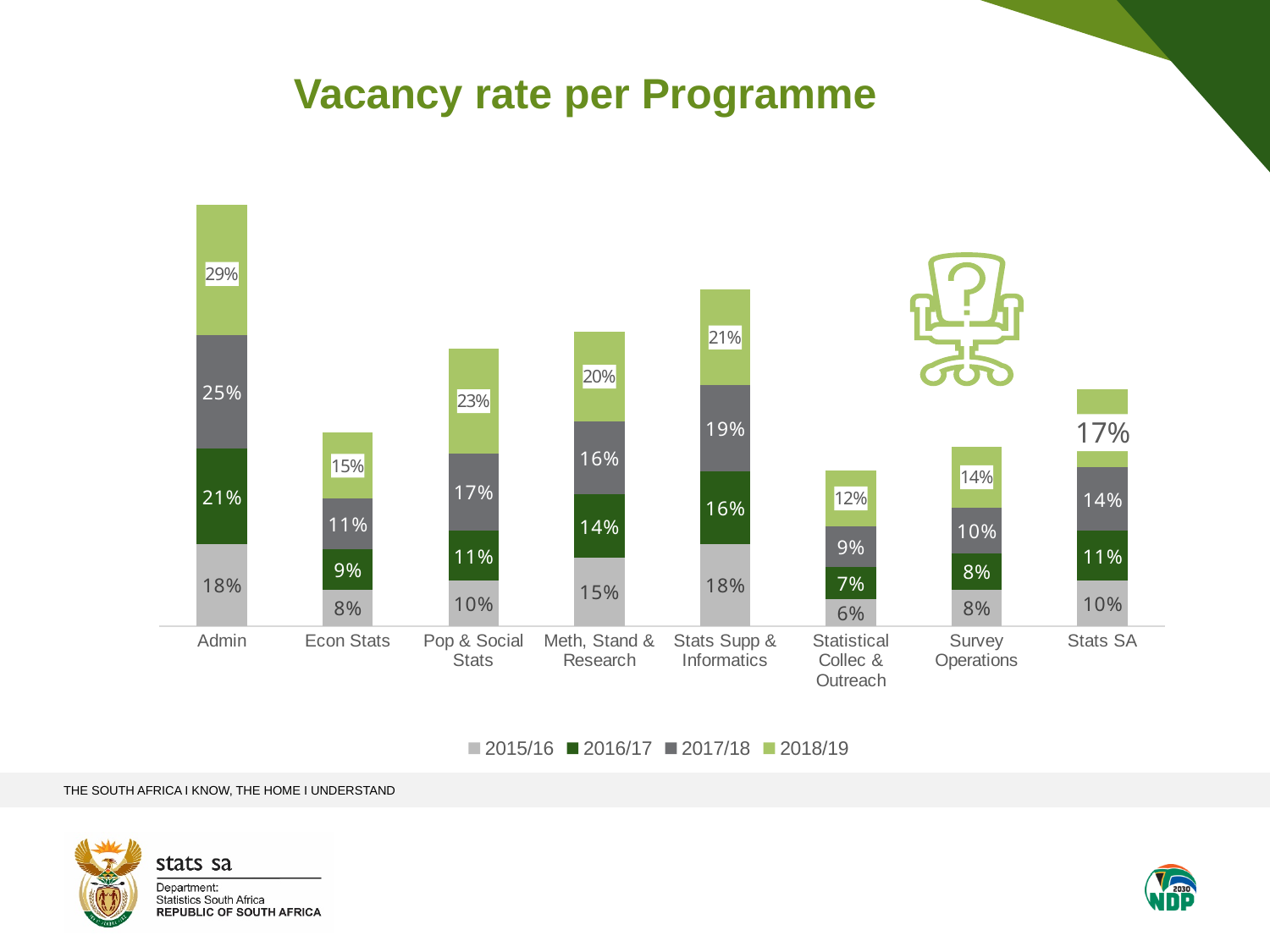
Which programme has the highest 2018/19 vacancy rate? Admin Which programme has the lowest 2015/16 vacancy rate? Statistical Collec & Outreach What is the title of the chart? Vacancy rate per Programme How many programmes are shown on the x axis? 8 What is the difference between the 2018/19 and 2015/16 vacancy rates for Econ Stats? 7% What is the 2015/16 vacancy rate for Stats Supp & Informatics? 18% What is the 2018/19 vacancy rate for Admin? 29% What kind of chart is shown on the slide? Stacked bar chart What is the 2016/17 vacancy rate for Statistical Collec & Outreach? 7% How many series does the legend list? 4 What is the 2017/18 vacancy rate for Pop & Social Stats? 17% Which is larger, the 2017/18 vacancy rate for Meth, Stand & Research or for Survey Operations? Meth, Stand & Research